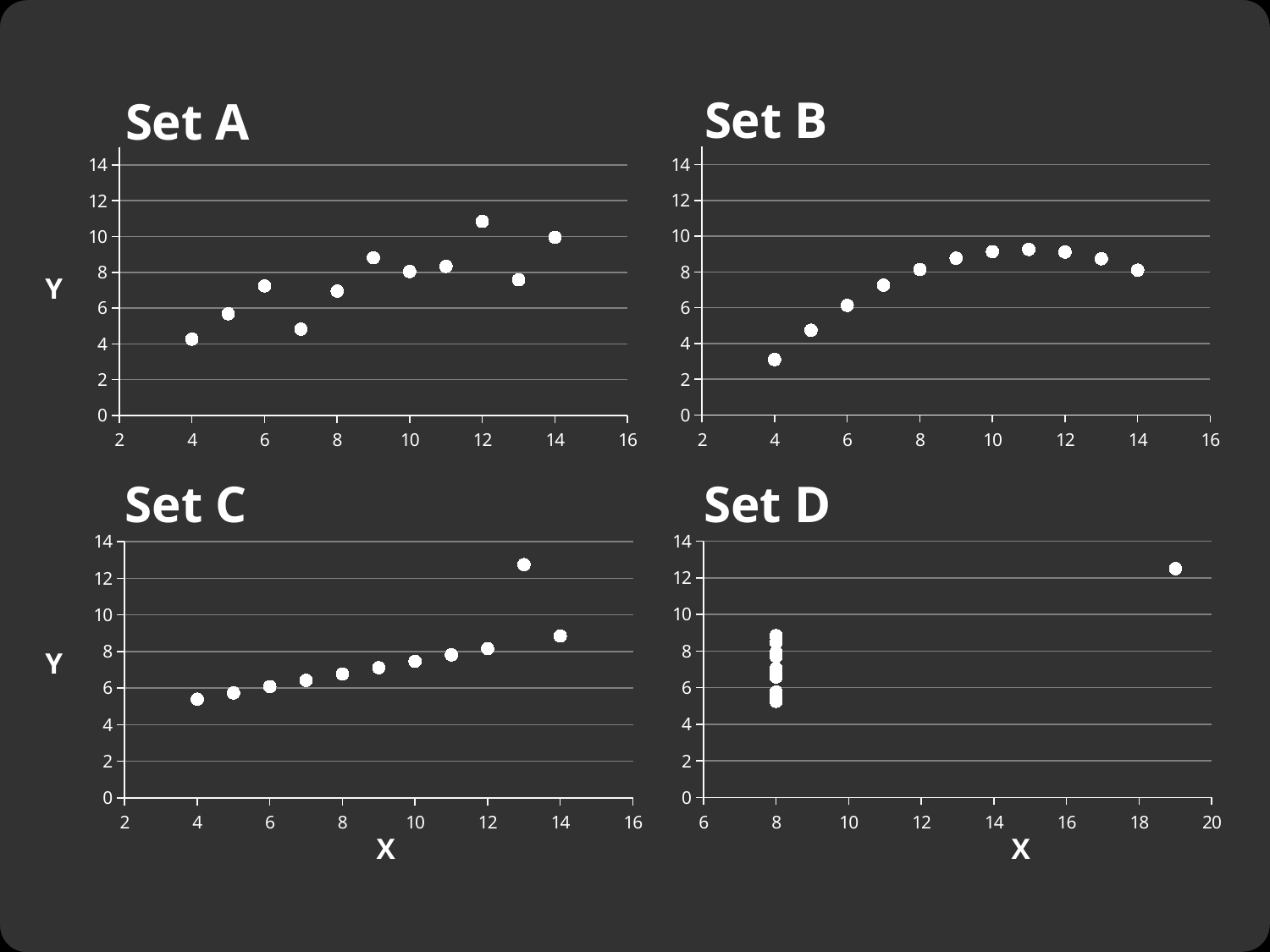
In Set B, at which x value is the y value lowest? 4 In Set C, at which x value is the y value highest? 13 In Set A, which has the larger y value, x = 6 or x = 7? x = 6 In Set D, is the y value at x = 19 greater or less than 12? greater In Set B, which has the larger y value, x = 6 or x = 10? x = 10 In Set A, how many data points are plotted? 11 In Set C, do the y values generally rise or fall as x increases? rise What kind of chart is Set A? scatter chart In Set A, is the y value at x = 12 greater or less than 10? greater In Set A, at which x value is the y value highest? 12 In Set B, is the y value at x = 4 greater or less than 4? less What are the titles of the four charts on the slide? Set A, Set B, Set C, Set D